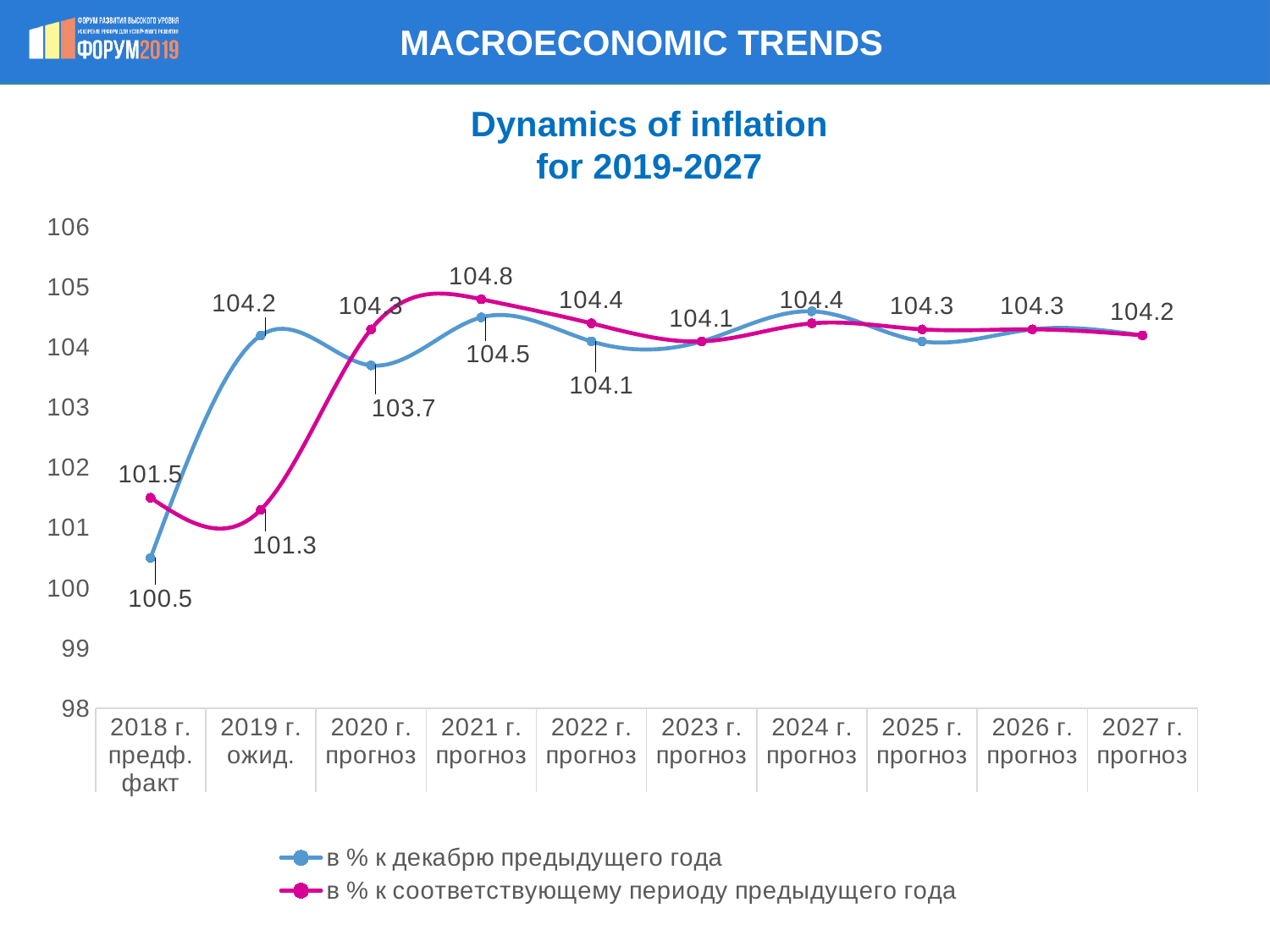
How many categories are shown on the x axis? 10 What is the value of the series 'в % к соответствующему периоду предыдущего года' for 2021 г. прогноз? 104.8 What is the value of the series 'в % к декабрю предыдущего года' for 2020 г. прогноз? 103.7 What is the title of the chart? Dynamics of inflation for 2019-2027 What kind of chart is shown on the slide? line chart How many series does the legend list? 2 For 2019 г. ожид., which series has the larger value: 'в % к декабрю предыдущего года' or 'в % к соответствующему периоду предыдущего года'? в % к декабрю предыдущего года What is the value of the series 'в % к соответствующему периоду предыдущего года' for 2018 г. предф. факт? 101.5 In which category does the series 'в % к соответствующему периоду предыдущего года' reach its highest value? 2021 г. прогноз What is the difference between the 2019 г. ожид. and 2018 г. предф. факт values of the series 'в % к декабрю предыдущего года'? 3.7 In which category does the series 'в % к декабрю предыдущего года' have its lowest value? 2018 г. предф. факт What is the value of the series 'в % к декабрю предыдущего года' for 2018 г. предф. факт? 100.5